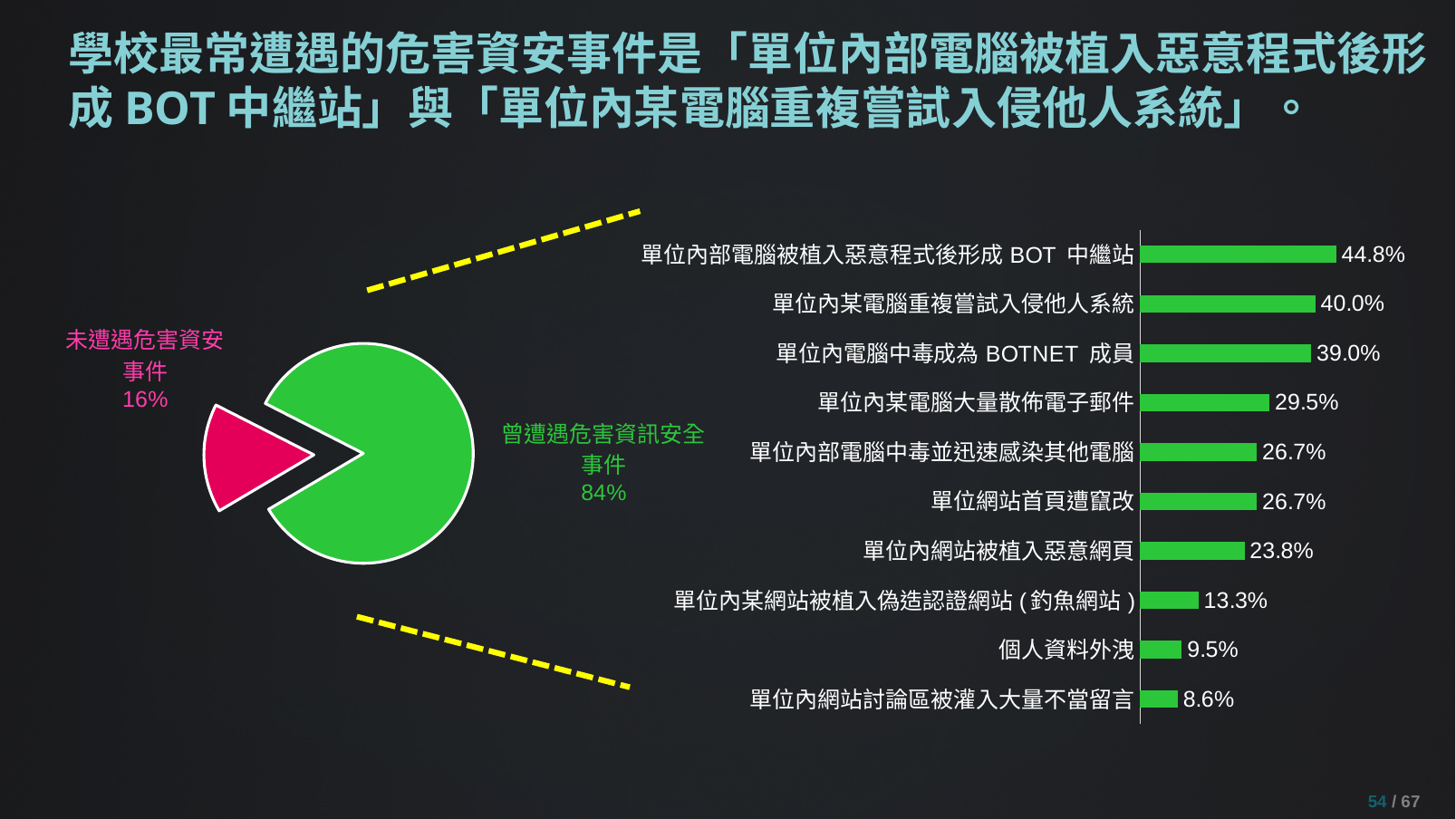
In the bar chart on the right, what is the value for 單位內某電腦大量散佈電子郵件? 29.5% How many categories does the bar chart on the right show? 10 In the bar chart on the right, which category has the highest value? 單位內部電腦被植入惡意程式後形成 BOT 中繼站 In the bar chart on the right, what is the value for 個人資料外洩? 9.5% What kind of chart is on the left of the slide? Pie chart In the bar chart on the right, which category has the lowest value? 單位內網站討論區被灌入大量不當留言 In the bar chart on the right, what is the difference between 單位內某電腦重複嘗試入侵他人系統 and 單位內電腦中毒成為 BOTNET 成員? 1.0% In the pie chart on the left, what share is labelled 曾遭遇危害資訊安全事件? 84% In the bar chart on the right, what is the value for 單位內部電腦被植入惡意程式後形成 BOT 中繼站? 44.8% In the pie chart on the left, what share is labelled 未遭遇危害資安事件? 16% In the bar chart on the right, which is larger: 單位內網站被植入惡意網頁 or 單位內某網站被植入偽造認證網站 ( 釣魚網站 )? 單位內網站被植入惡意網頁 What kind of chart is on the right of the slide? Bar chart